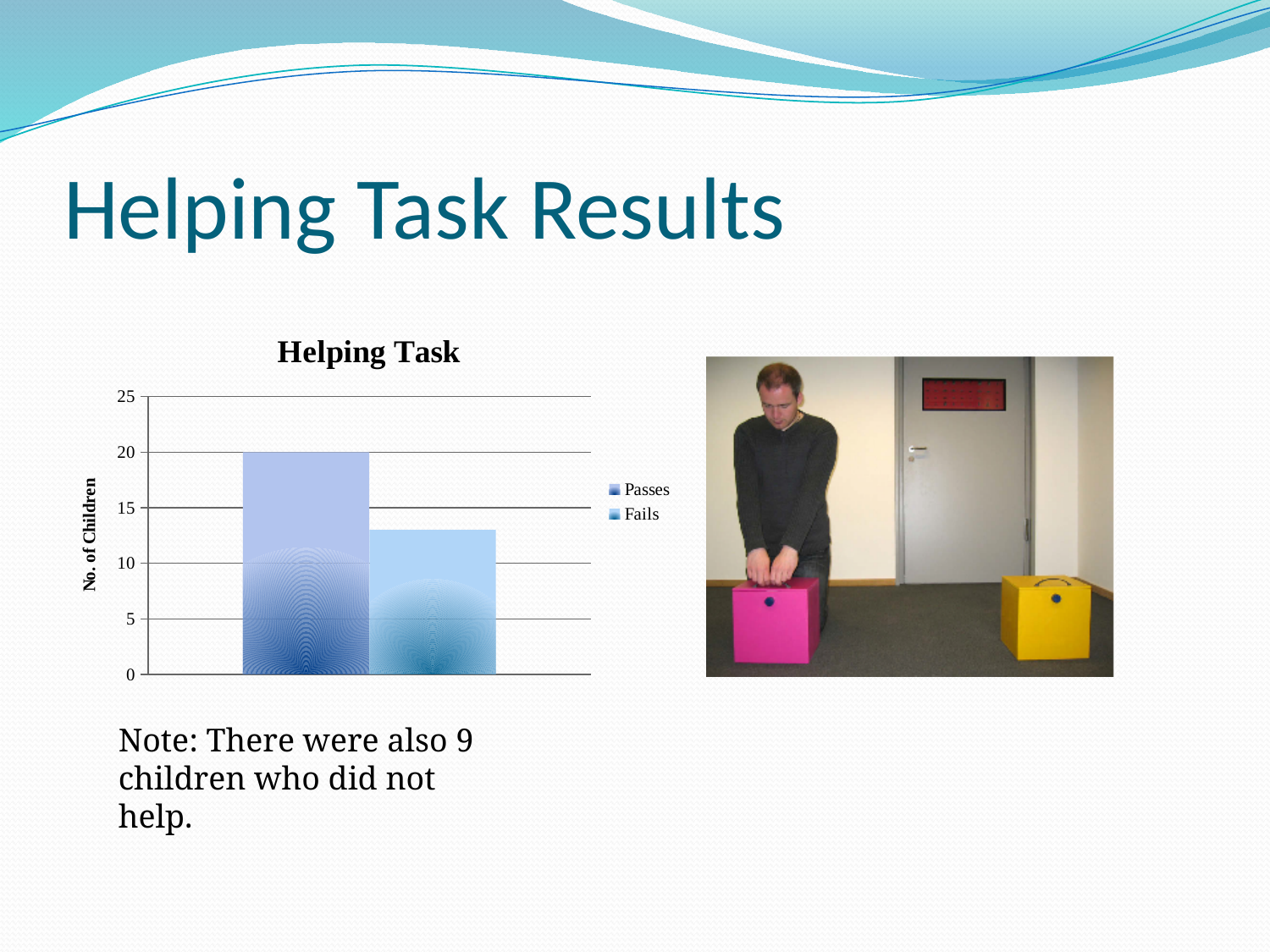
Which series has the lowest value in the "Helping Task" chart? Fails Is the value for Fails in the "Helping Task" chart greater or less than 15? less What is the highest value shown on the vertical axis of the "Helping Task" chart? 25 How many series does the legend of the "Helping Task" chart list? 2 Which series has the highest value in the "Helping Task" chart? Passes Which series has the higher value in the "Helping Task" chart, Passes or Fails? Passes What is the value for Passes in the "Helping Task" chart? 20 What is the label on the vertical axis of the "Helping Task" chart? No. of Children Is the value for Passes in the "Helping Task" chart greater or less than 25? less What kind of chart is shown under the title "Helping Task"? bar chart Is the value for Fails in the "Helping Task" chart greater or less than 10? greater What are the two legend entries in the "Helping Task" chart? Passes and Fails